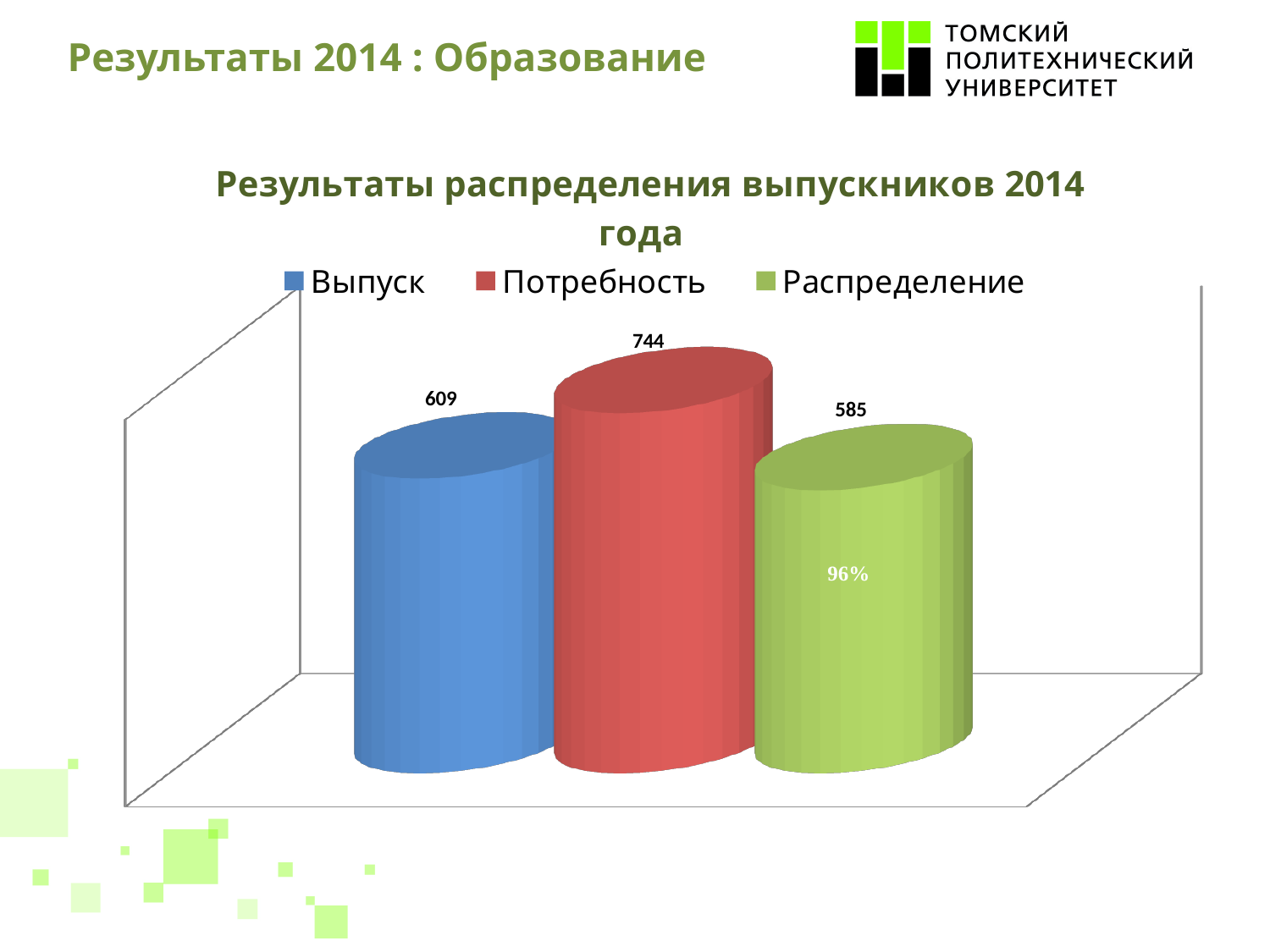
Which is larger, the value for Выпуск or the value for Потребность? Потребность What is the value for Выпуск? 609 What percentage label is printed on the Распределение bar? 96% What is the value for Распределение? 585 What is the value for Потребность? 744 Which series has the highest value? Потребность What is the difference between the values for Потребность and Выпуск? 135 What is the title of the chart? Результаты распределения выпускников 2014 года Which series has the lowest value? Распределение How many series does the legend list? 3 What kind of chart is shown on the slide? bar chart What is the difference between the values for Выпуск and Распределение? 24